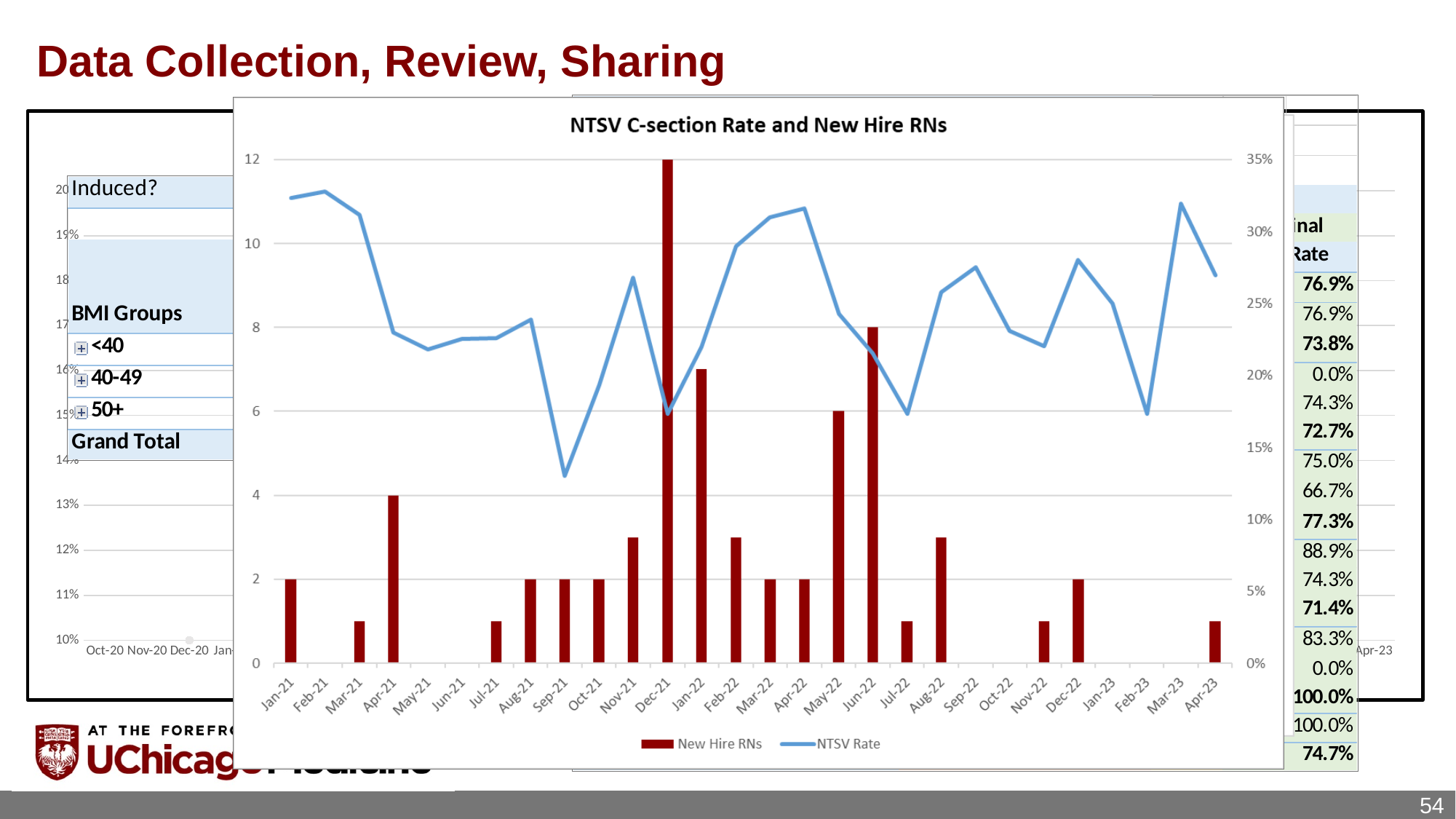
In the NTSV C-section Rate and New Hire RNs chart, how many New Hire RNs are shown for Dec-21? 12 In the NTSV C-section Rate and New Hire RNs chart, which month has the lowest NTSV Rate? Sep-21 What is the title of the chart on the slide? NTSV C-section Rate and New Hire RNs In the NTSV C-section Rate and New Hire RNs chart, what is the difference in New Hire RNs between Dec-21 and Jun-22? 4 What kind of chart is the NTSV C-section Rate and New Hire RNs chart? Combination bar and line chart In the NTSV C-section Rate and New Hire RNs chart, is the NTSV Rate for Sep-21 greater or less than 15%? less How many series does the legend of the NTSV C-section Rate and New Hire RNs chart list? 2 In the NTSV C-section Rate and New Hire RNs chart, how many New Hire RNs are shown for Apr-21? 4 Which series in the NTSV C-section Rate and New Hire RNs chart is shown as bars? New Hire RNs In the NTSV C-section Rate and New Hire RNs chart, how many New Hire RNs are shown for Jun-22? 8 In the NTSV C-section Rate and New Hire RNs chart, which month has the highest number of New Hire RNs? Dec-21 In the NTSV C-section Rate and New Hire RNs chart, which month has more New Hire RNs, Dec-21 or May-22? Dec-21